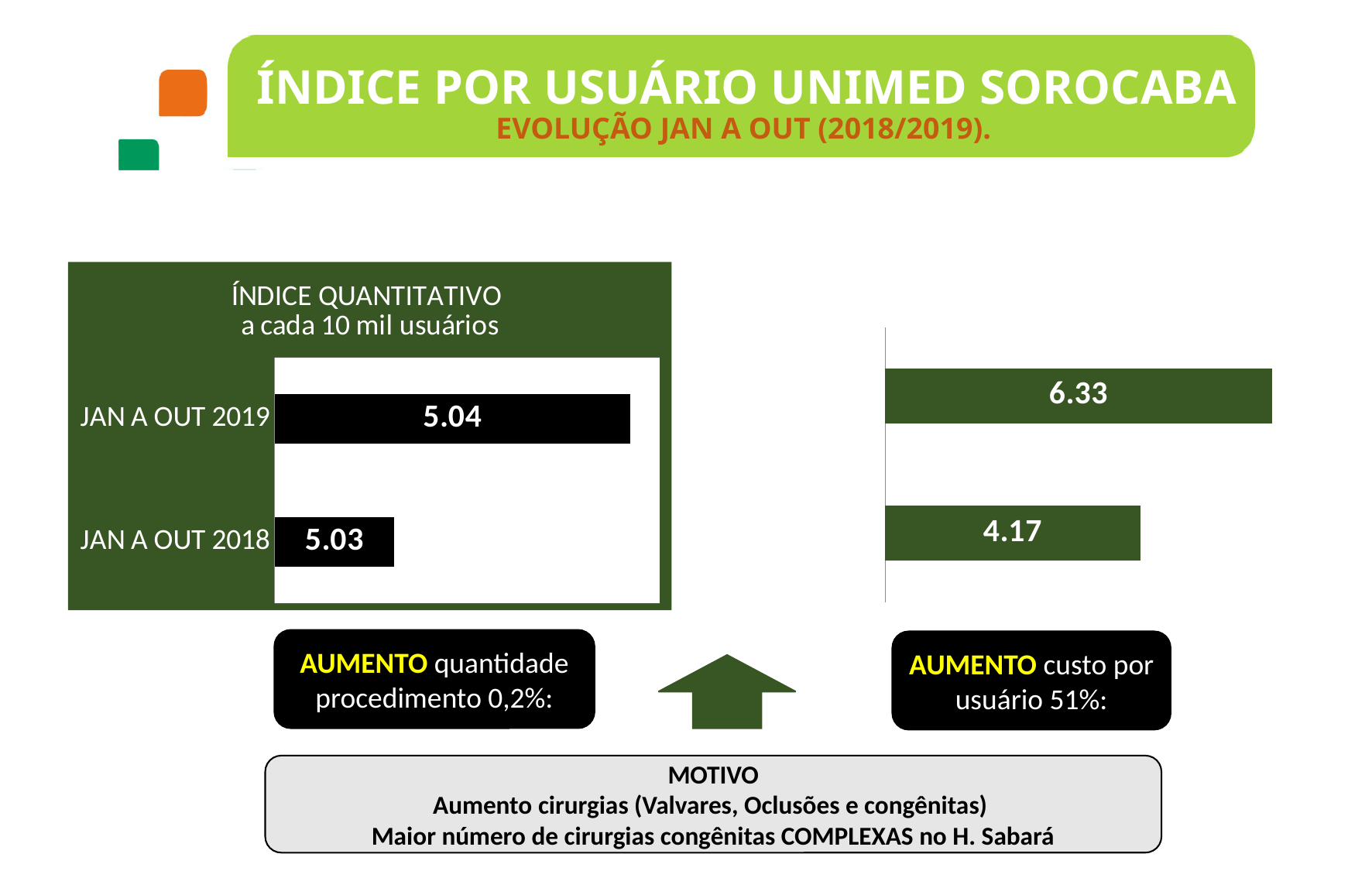
In the left chart titled ÍNDICE QUANTITATIVO, what is the value for JAN A OUT 2018? 5.03 In the right chart, what is the difference between the top bar value and the bottom bar value? 2.16 In the left chart titled ÍNDICE QUANTITATIVO, how many bars are plotted? 2 In the right chart, how many bars are plotted? 2 What is the subtitle printed under the left chart's title ÍNDICE QUANTITATIVO? a cada 10 mil usuários In the right chart, what is the value shown on the top bar? 6.33 What kind of chart is the right chart on the slide? bar chart In the right chart, what is the value shown on the bottom bar? 4.17 In the left chart titled ÍNDICE QUANTITATIVO, what is the value for JAN A OUT 2019? 5.04 In the left chart titled ÍNDICE QUANTITATIVO, what is the difference between the JAN A OUT 2019 and JAN A OUT 2018 values? 0.01 In the right chart, which bar is larger, the top bar or the bottom bar? top bar What kind of chart is the left chart titled ÍNDICE QUANTITATIVO? bar chart